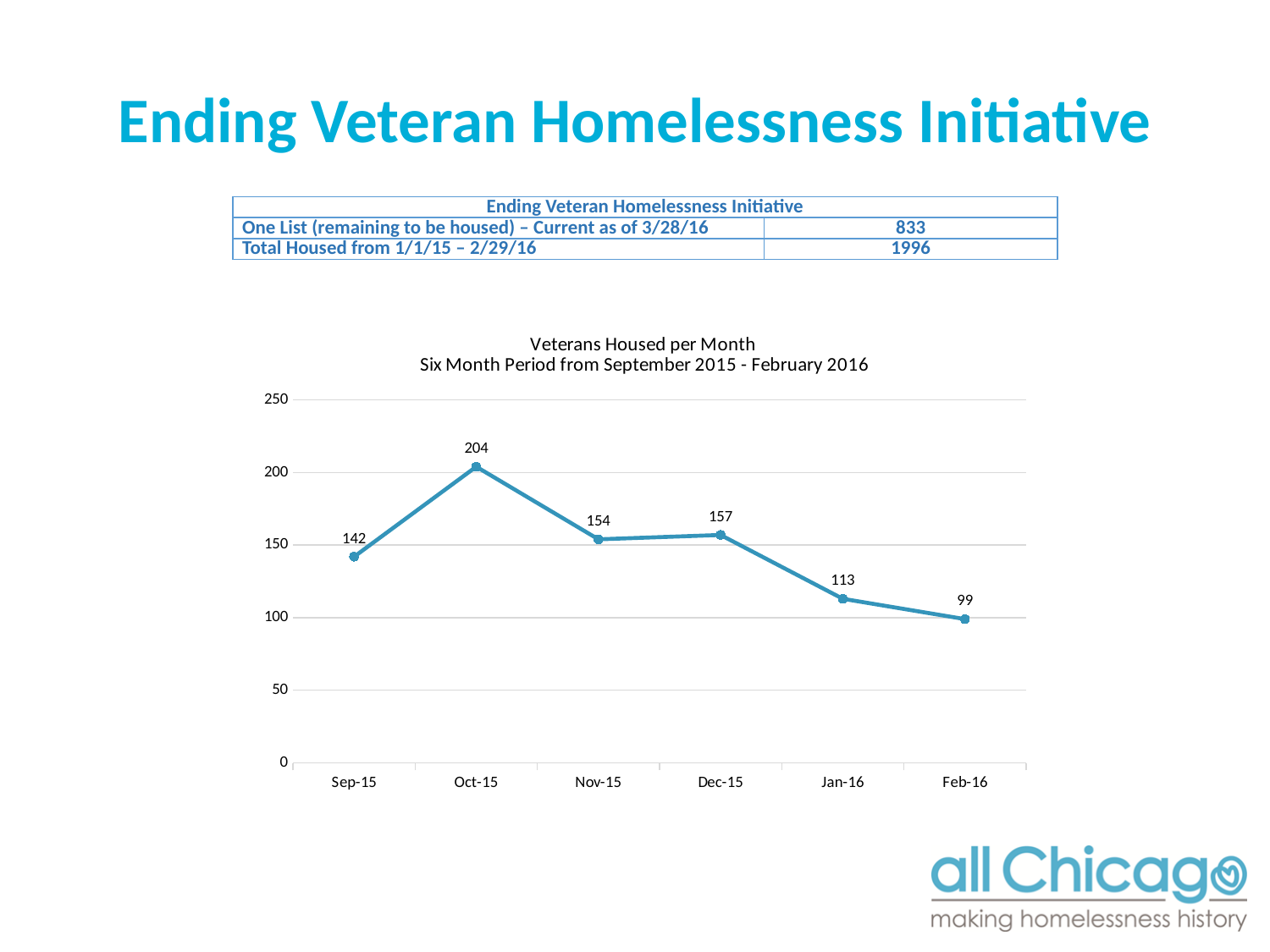
Which is larger, the value for Nov-15 or the value for Sep-15? Nov-15 Is the value for Feb-16 greater or less than 100? less How many months are plotted on the chart? 6 Do the values rise or fall from Dec-15 to Feb-16? fall Which month has the lowest number of veterans housed? Feb-16 What is the difference between the values for Oct-15 and Feb-16? 105 What is the value for Jan-16? 113 What is the value for Sep-15? 142 What is the value for Oct-15? 204 What is the difference between the values for Dec-15 and Jan-16? 44 What kind of chart is shown on the slide? line chart Which month has the highest number of veterans housed? Oct-15